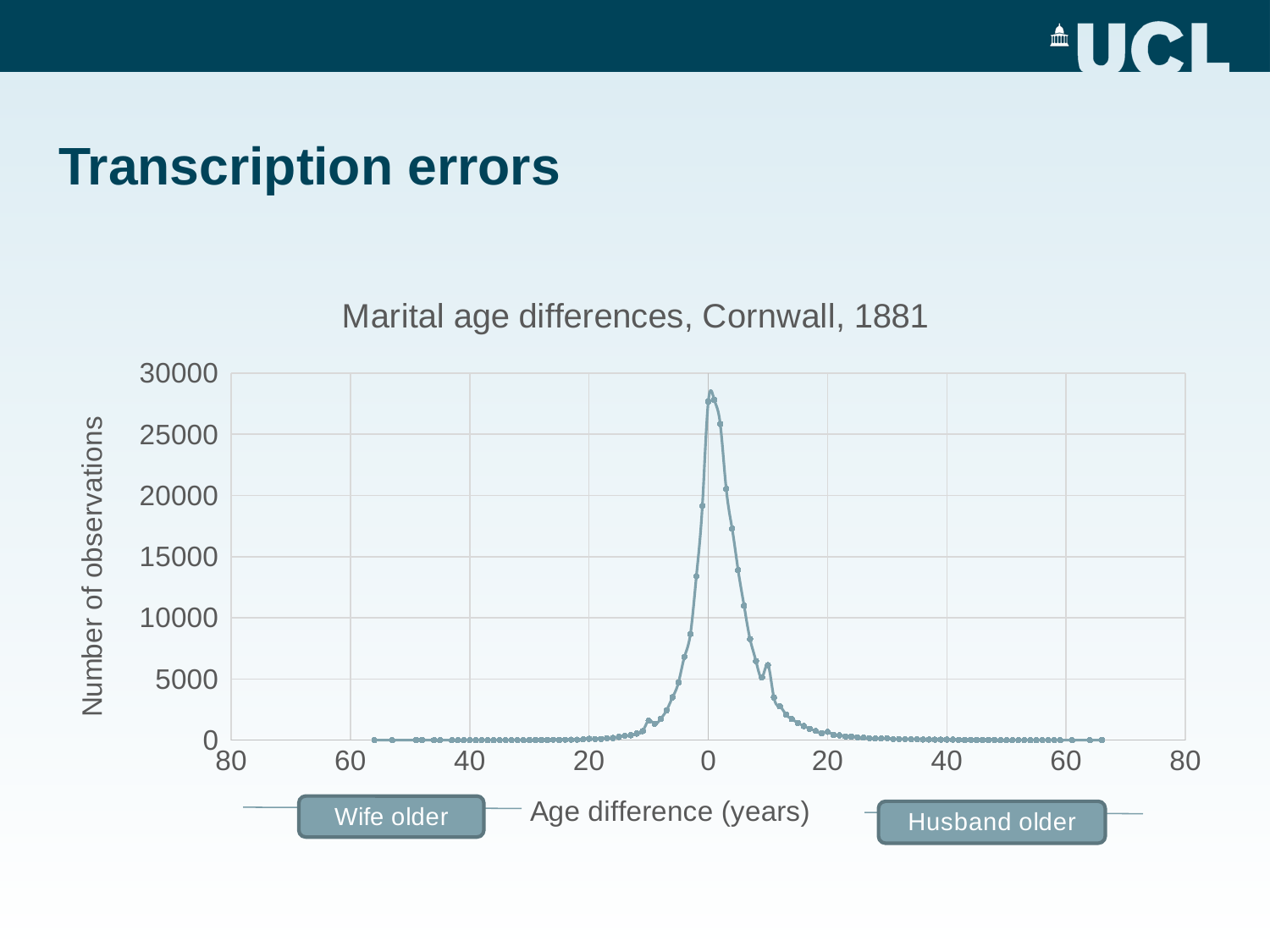
What is the label on the vertical axis of the chart? Number of observations Is the highest value on the curve greater or less than 25000? greater Is the value at an age difference of 40 years (wife older) greater or less than 5000? less How many data series are plotted on the chart? 1 What is the highest tick value shown on the vertical axis? 30000 What is the title of the chart? Marital age differences, Cornwall, 1881 Is the value at an age difference of 0 years greater or less than 20000? greater Is the peak of the curve closer to an age difference of 0 or 20 years? 0 What kind of chart is shown on the slide? line chart Moving right along the x axis from 0 to 20 years (husband older), do the values rise or fall? fall Moving right along the x axis from 20 years (wife older) to 0, do the values rise or fall? rise